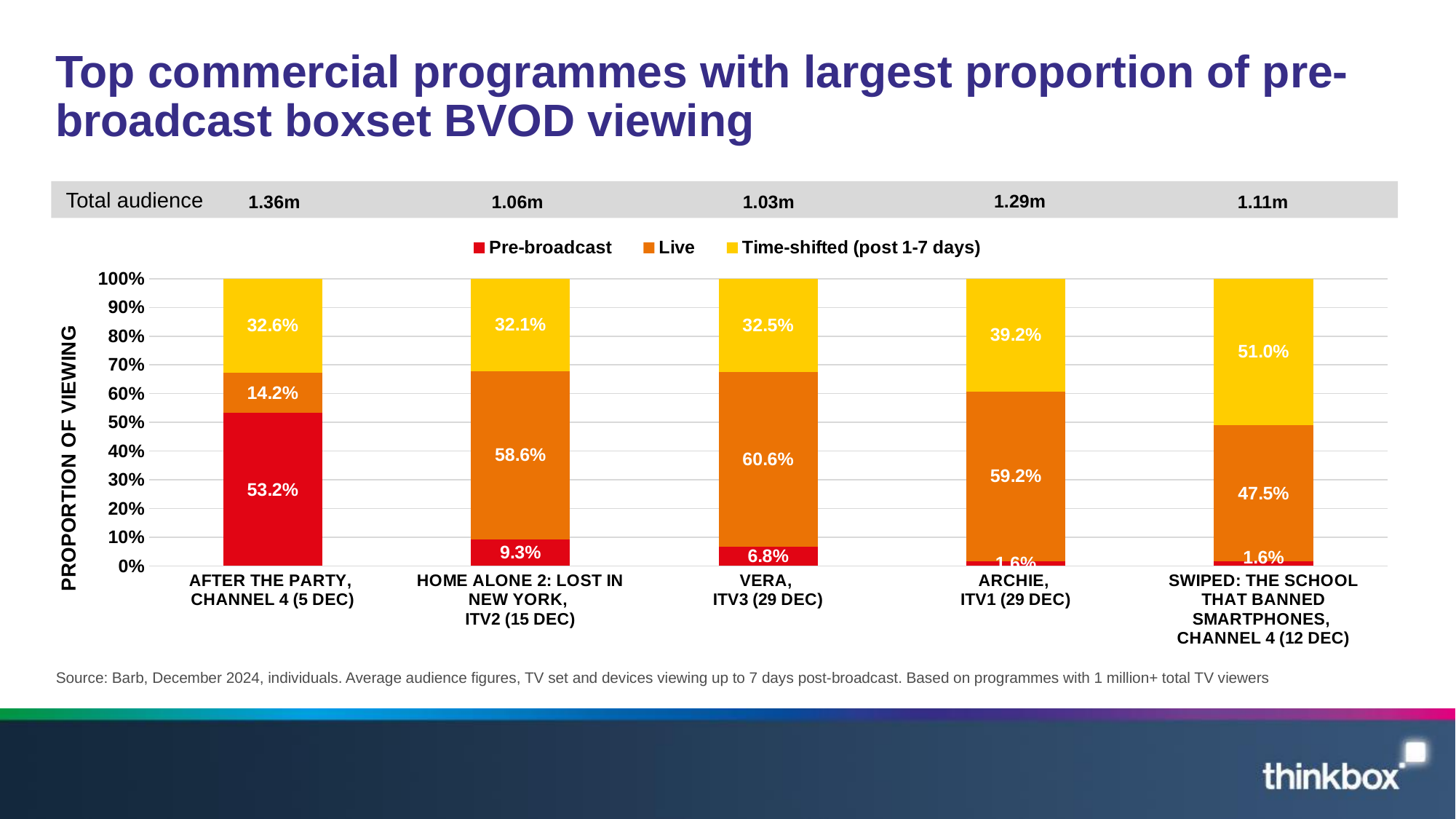
What is the difference in percentage points between the Live proportion for Home Alone 2: Lost in New York and the Live proportion for After the Party? 44.4 percentage points Is the Live proportion for Swiped: The School That Banned Smartphones greater or less than 50%? less What is the Pre-broadcast proportion for Home Alone 2: Lost in New York, ITV2 (15 Dec)? 9.3% What is the Time-shifted (post 1-7 days) proportion for Swiped: The School That Banned Smartphones, Channel 4 (12 Dec)? 51.0% How many series does the legend list? 3 What kind of chart is shown on the slide? Stacked bar chart Which programme has the highest Pre-broadcast proportion? After the Party, Channel 4 (5 Dec) What is the Pre-broadcast proportion for After the Party, Channel 4 (5 Dec)? 53.2% Which programme has the highest Time-shifted (post 1-7 days) proportion? Swiped: The School That Banned Smartphones, Channel 4 (12 Dec) What is the Live proportion for Vera, ITV3 (29 Dec)? 60.6% Which has a larger Time-shifted (post 1-7 days) proportion: Archie, ITV1 (29 Dec) or Vera, ITV3 (29 Dec)? Archie, ITV1 (29 Dec) How many programmes are shown on the chart? 5